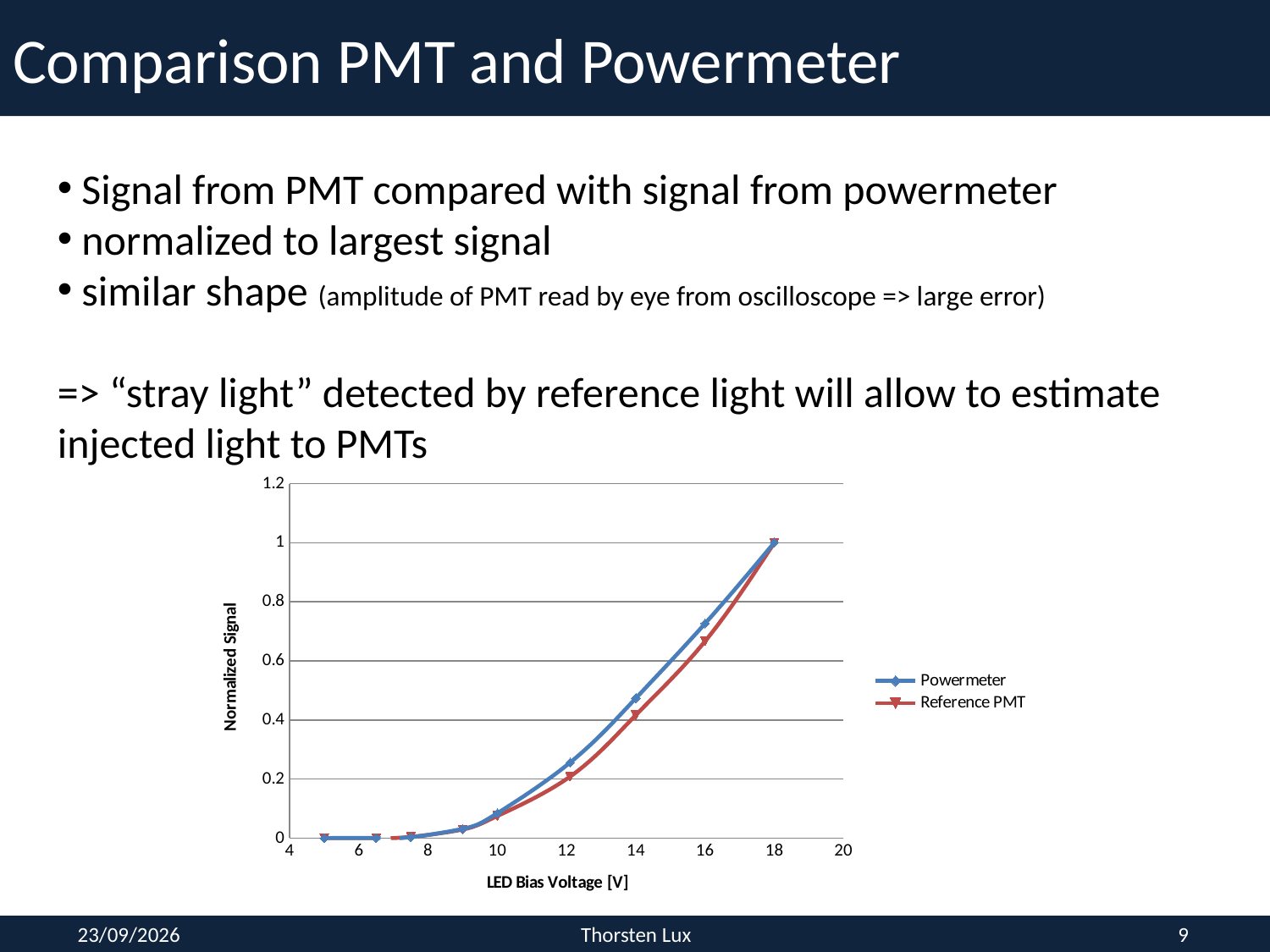
What are the two series named in the chart legend? Powermeter and Reference PMT Is the Powermeter value at 14 V greater or less than 0.4? greater What kind of chart is shown on the slide? line chart Is the Powermeter value at 18 V greater or less than 0.8? greater Is the Reference PMT value at 12 V greater or less than 0.4? less Do the Powermeter values rise or fall as LED bias voltage increases along the x axis? rise At 16 V, which series has the larger normalized signal, Powermeter or Reference PMT? Powermeter How many series does the chart legend list? 2 What is the label of the x axis of the chart? LED Bias Voltage [V] At which LED bias voltage does the Reference PMT series reach its highest normalized signal? 18